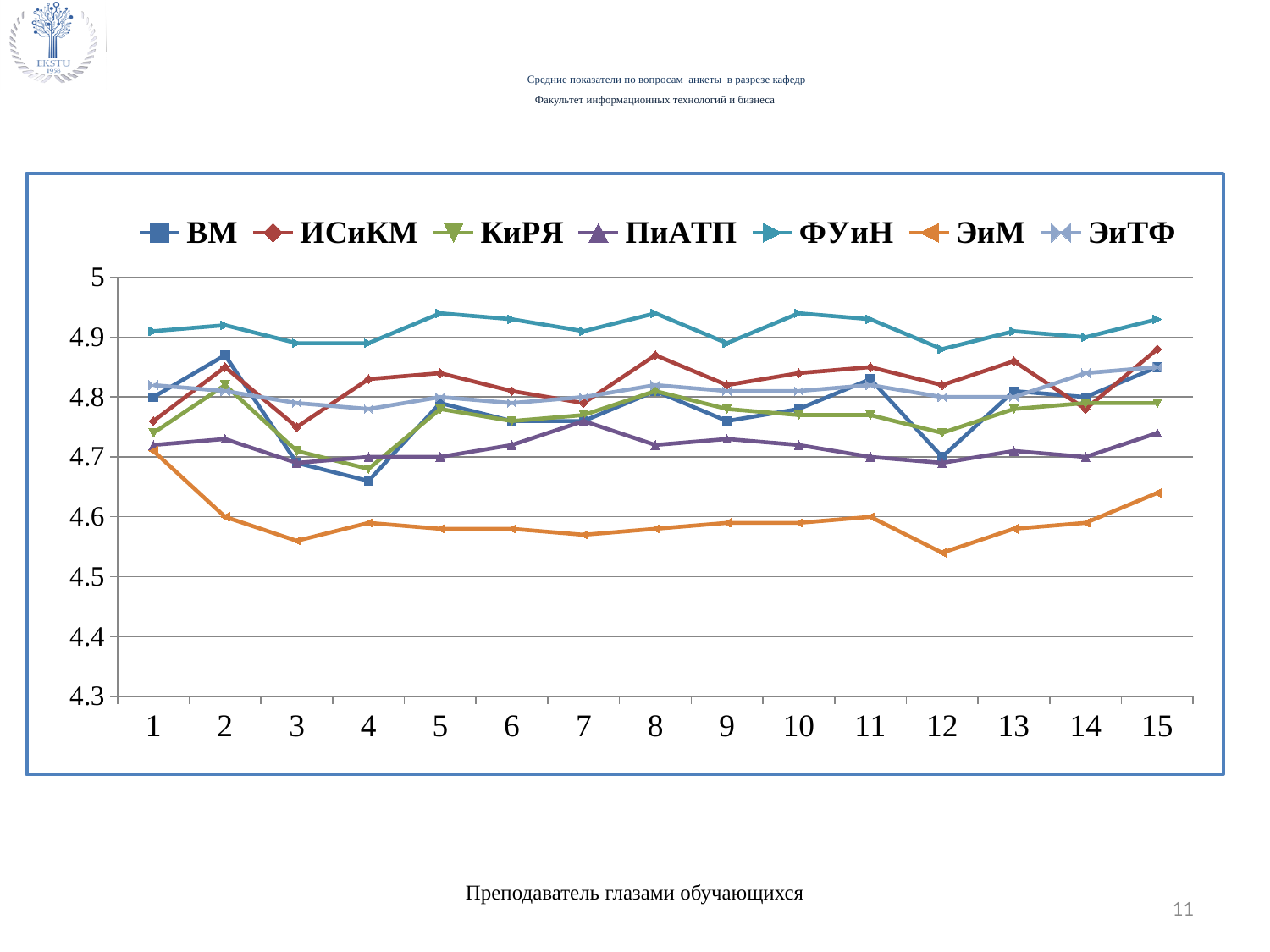
At point 2, which is larger: the value for ВМ or the value for ЭиМ? ВМ Is the value for ФУиН at point 5 greater or less than 4.9? greater Is the value for ВМ at point 4 greater or less than 4.7? less What is the first series listed in the legend? ВМ What kind of chart is shown on the slide? line chart Do the values for ЭиМ rise or fall from point 12 to point 15? rise How many series does the legend list? 7 Which series has the lowest value at point 12? ЭиМ Is the value for ЭиМ at point 12 greater or less than 4.6? less How many points are there along the x axis? 15 Which series has the highest value at point 8? ФУиН